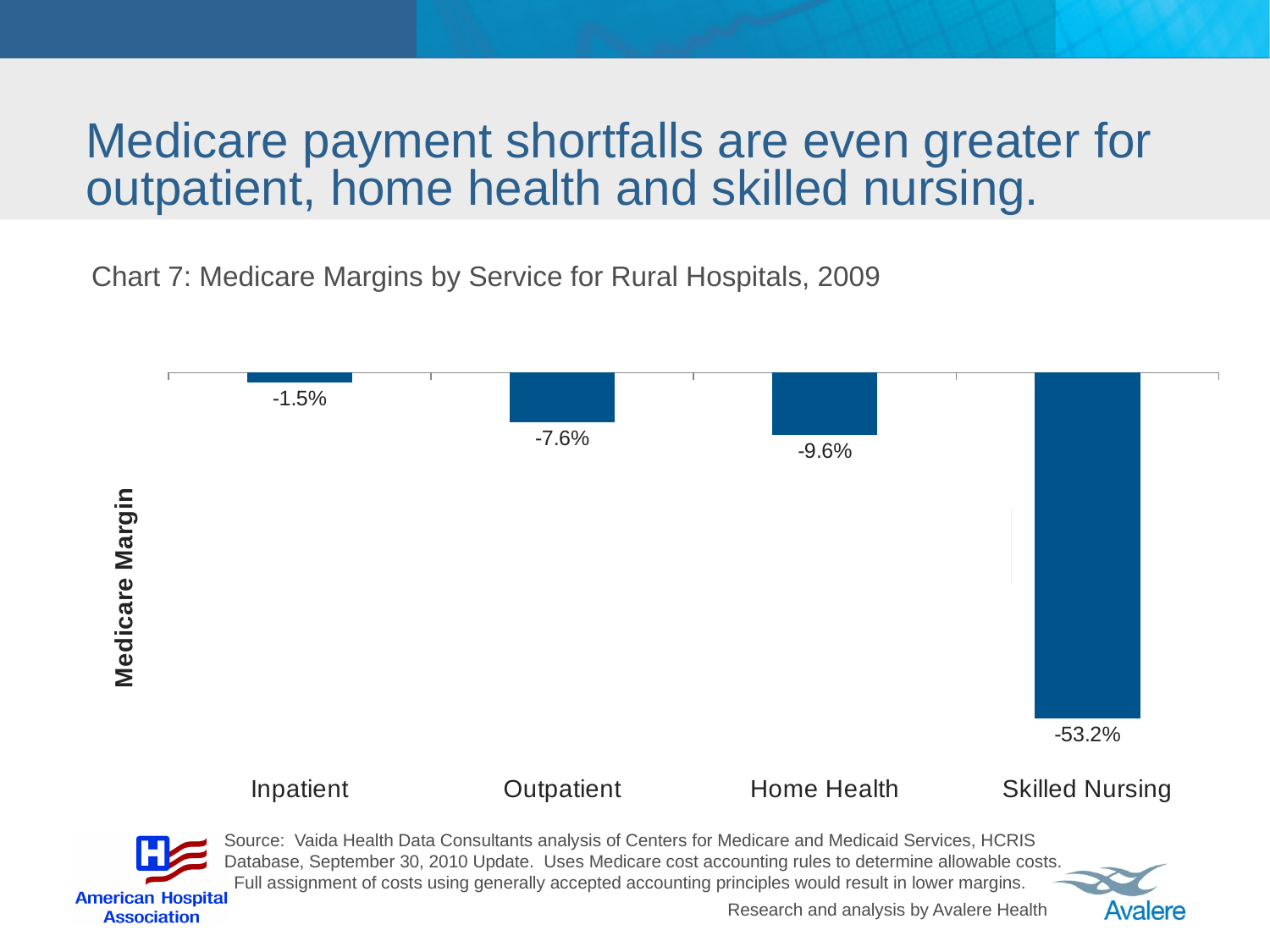
How many services are shown in the chart? 4 Which service has the lowest Medicare margin? Skilled Nursing What kind of chart is shown on the slide? Bar chart Which has a larger (less negative) Medicare margin, Outpatient or Home Health? Outpatient What is the difference between the Medicare margins for Inpatient and Skilled Nursing? 51.7 percentage points What is the difference between the Medicare margins for Home Health and Outpatient? 2.0 percentage points Which service has the highest Medicare margin? Inpatient What is the Medicare margin for Home Health? -9.6% What is the Medicare margin for Skilled Nursing? -53.2% What is the title of the chart? Chart 7: Medicare Margins by Service for Rural Hospitals, 2009 What is the Medicare margin for Inpatient? -1.5% What is the Medicare margin for Outpatient? -7.6%